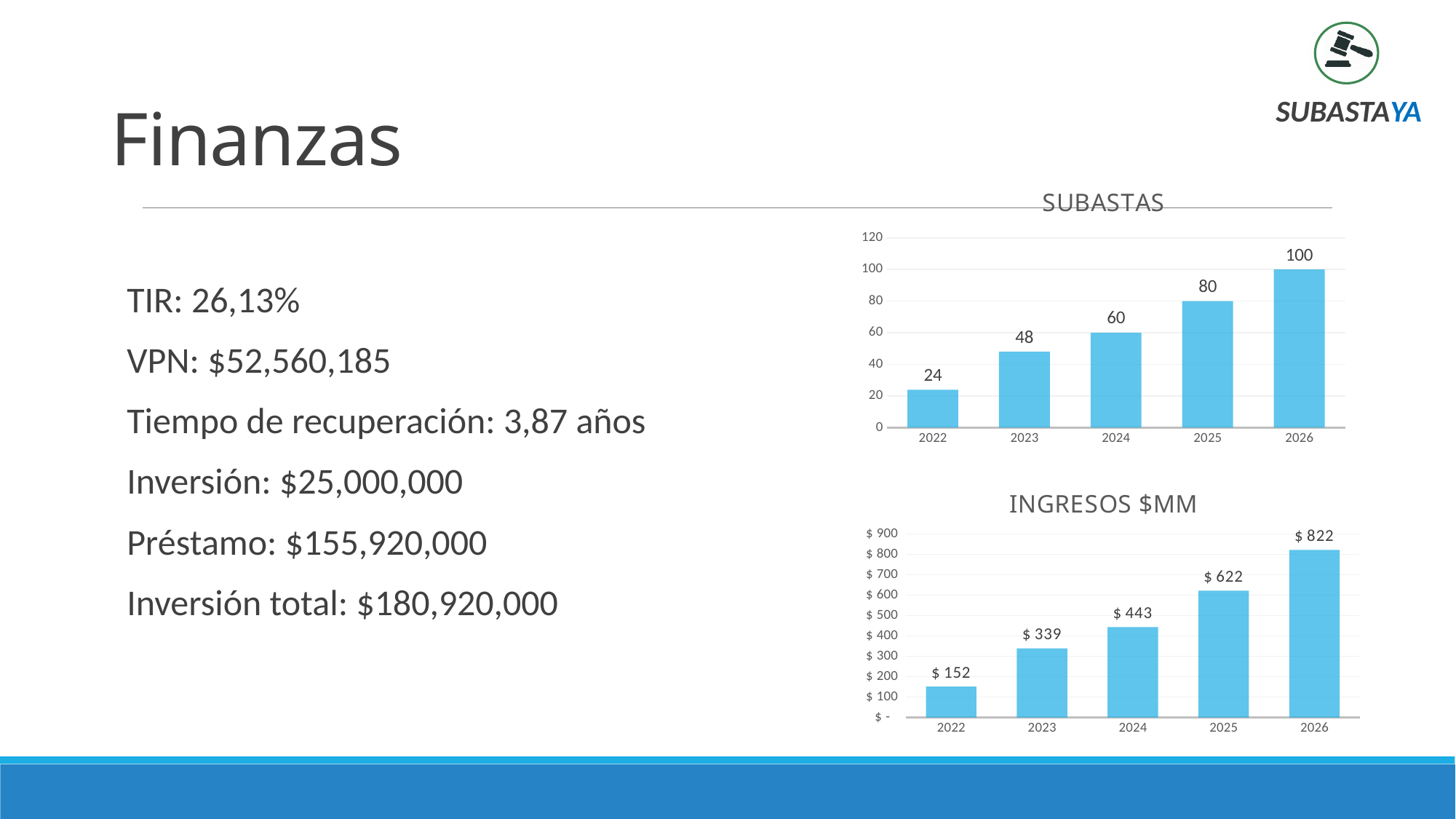
In the INGRESOS $MM chart, which is larger, the value for 2024 or the value for 2025? 2025 In the SUBASTAS chart, how many years are shown on the x axis? 5 In the SUBASTAS chart, which year has the highest value? 2026 In the SUBASTAS chart, do the values rise or fall from 2022 to 2026? rise What kind of chart is the INGRESOS $MM chart? bar chart In the INGRESOS $MM chart, what is the difference between the values for 2025 and 2024? $ 179 In the SUBASTAS chart, which year has the lowest value? 2022 In the SUBASTAS chart, what is the difference between the values for 2026 and 2022? 76 In the INGRESOS $MM chart, what is the value for 2026? $ 822 In the INGRESOS $MM chart, what is the value for 2023? $ 339 In the SUBASTAS chart, what is the value for 2024? 60 What is the title of the top chart on the slide? SUBASTAS